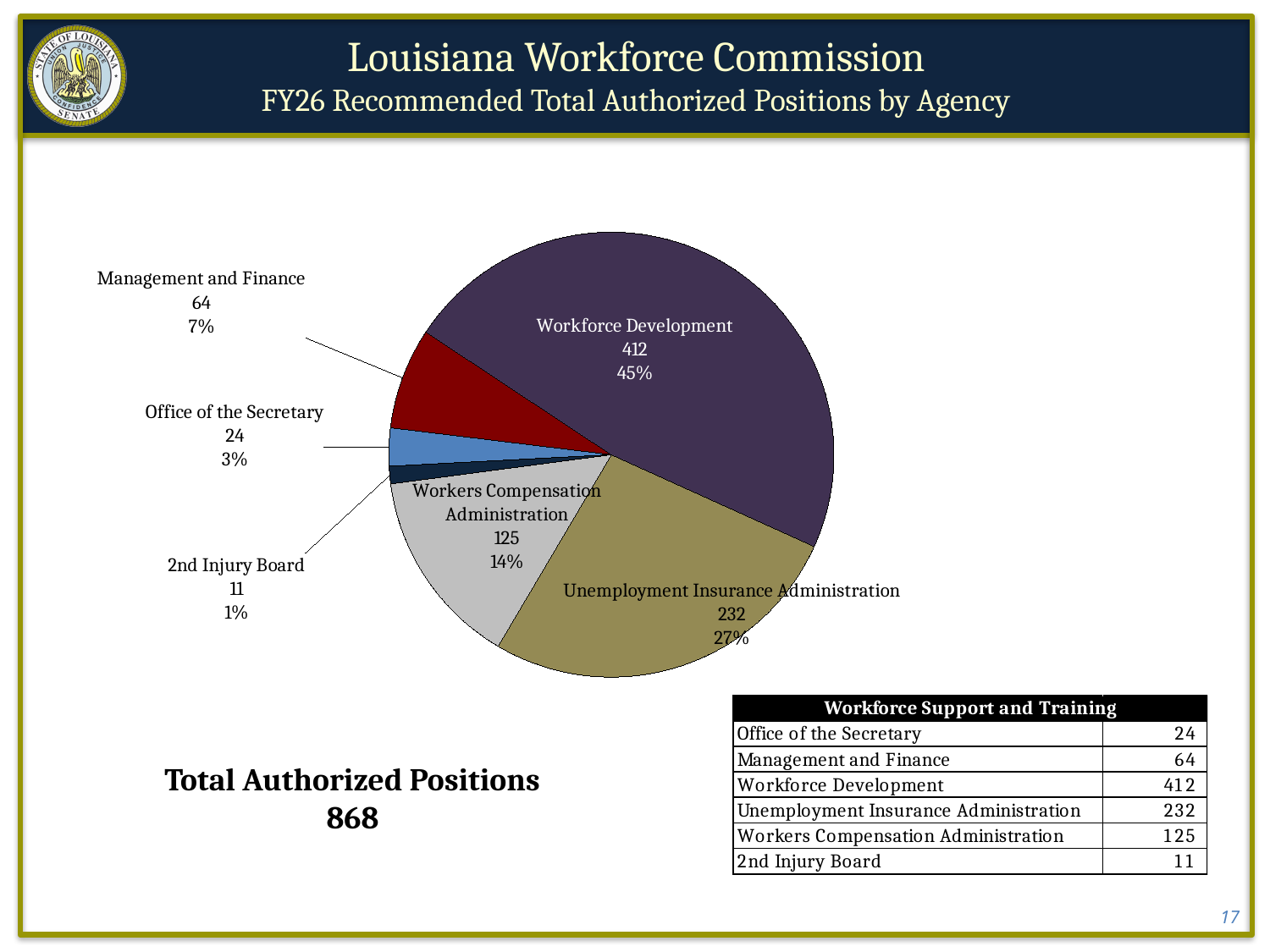
How many agencies (slices) are shown in the pie chart? 6 Which has more authorized positions, Management and Finance or Office of the Secretary? Management and Finance What percentage share of the pie does Management and Finance hold? 7% What is the subtitle of the slide describing the chart? FY26 Recommended Total Authorized Positions by Agency What is the total number of authorized positions shown on the slide? 868 Which agency has the smallest number of authorized positions? 2nd Injury Board What percentage share of the pie does Workers Compensation Administration hold? 14% How many authorized positions does Unemployment Insurance Administration have? 232 What kind of chart is shown on the slide? Pie chart Which agency has the largest number of authorized positions? Workforce Development What is the difference in authorized positions between Workforce Development and Unemployment Insurance Administration? 180 How many authorized positions does Workforce Development have? 412